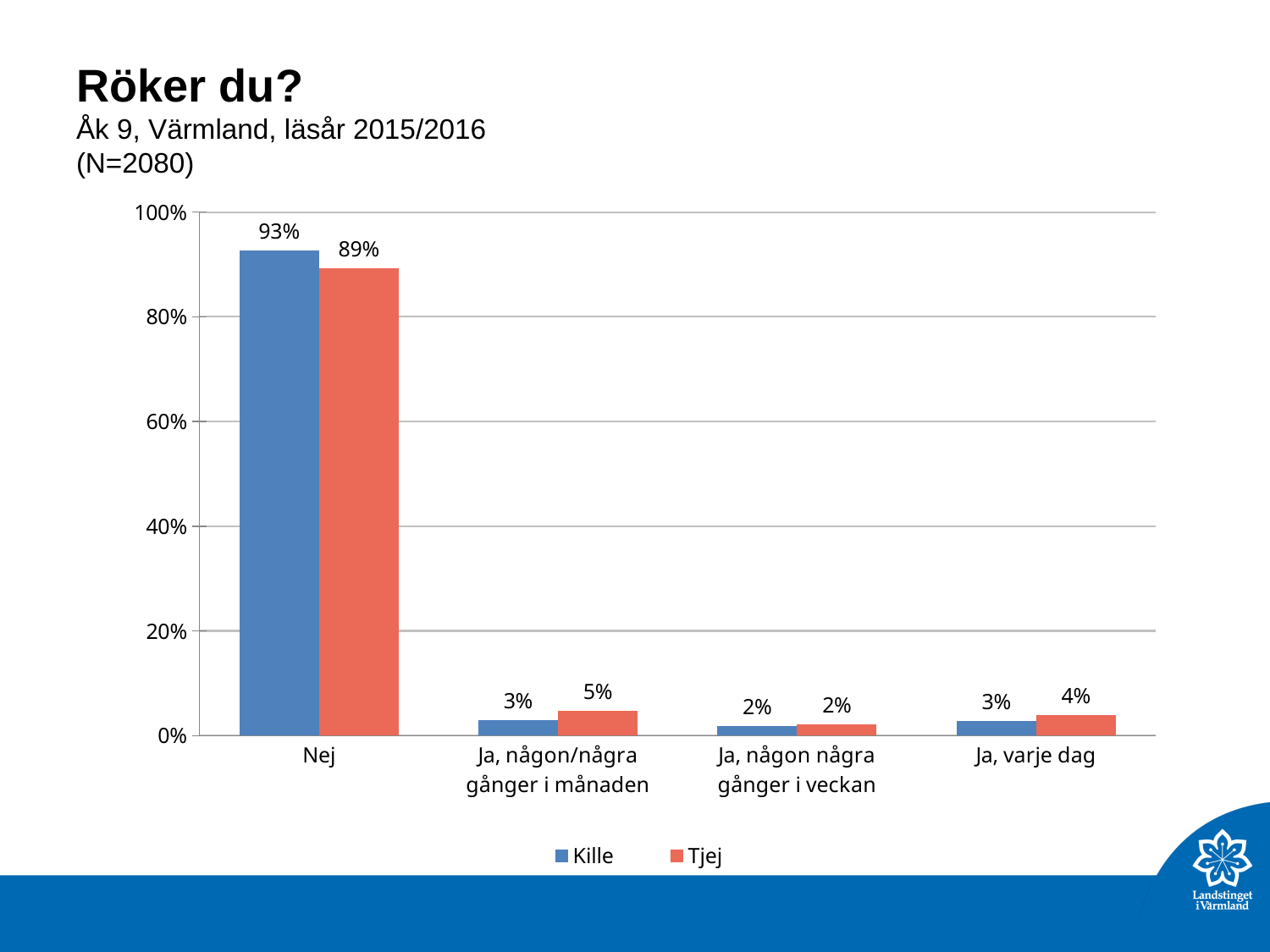
What is the difference between the Kille and Tjej values in the Nej category? 4% What is the value for Tjej in the 'Ja, någon/några gånger i månaden' category? 5% Which category has the highest value for Kille? Nej What is the value for Tjej in the Nej category? 89% Which category has the lowest value for Tjej? Ja, någon några gånger i veckan What is the value for Kille in the Nej category? 93% In the 'Ja, varje dag' category, which is larger, Kille or Tjej? Tjej Is the value for Tjej in the Nej category greater or less than 80%? greater How many series does the legend list? 2 What kind of chart is shown on the slide? Bar chart What is the value for Kille in the 'Ja, varje dag' category? 3% How many categories are shown on the x axis? 4